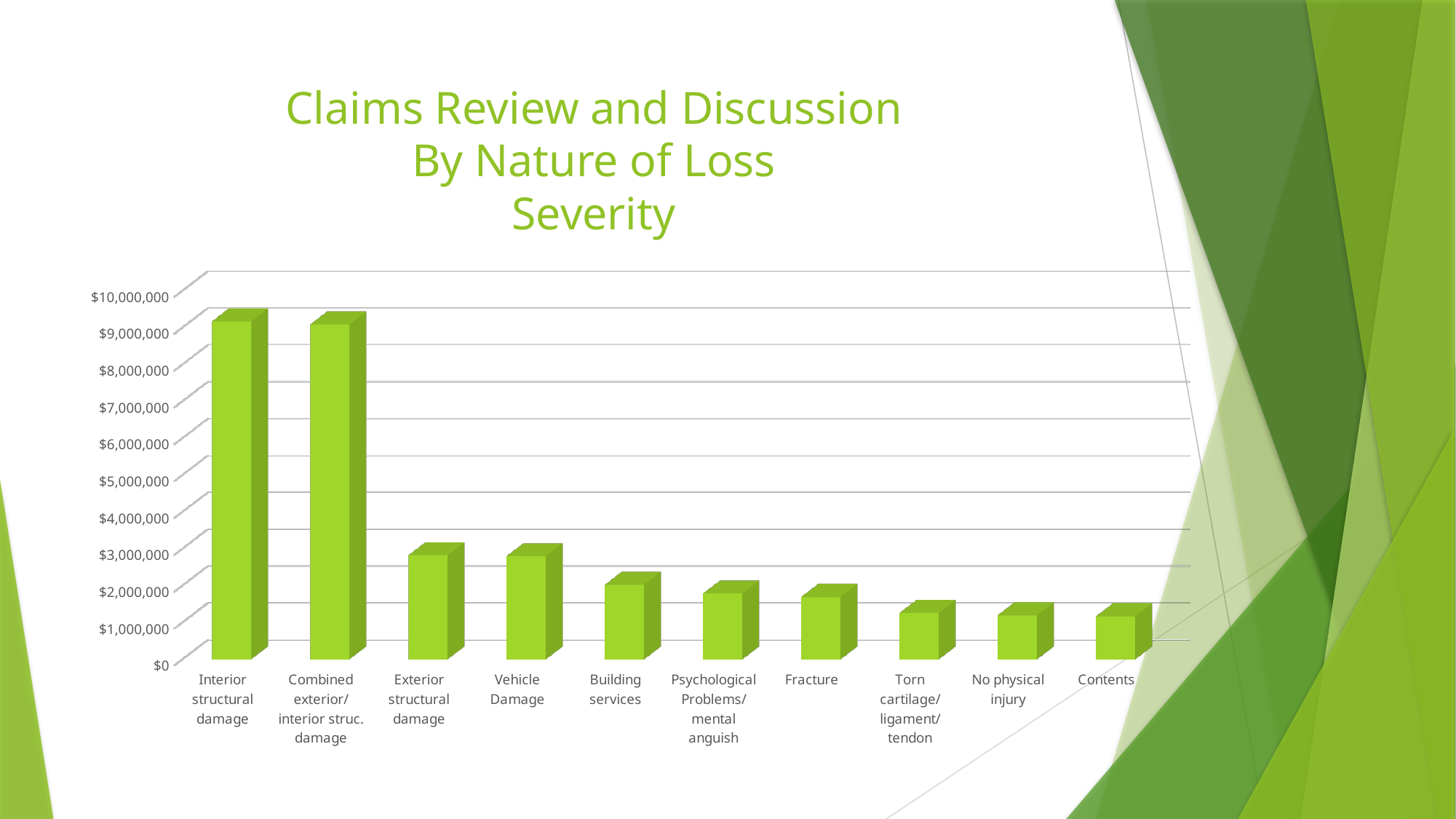
Is the value for Building services greater or less than $1,000,000? greater How many categories are plotted on the x axis of the chart? 10 Do the bar values generally rise or fall from left to right along the x axis? fall Is the value for Fracture greater or less than $3,000,000? less Is the value for Interior structural damage greater or less than $8,000,000? greater Which is larger, the value for Building services or the value for Contents? Building services Which is larger, the value for Interior structural damage or the value for Exterior structural damage? Interior structural damage What kind of chart is shown on the slide? bar chart What is the title of the slide containing the chart? Claims Review and Discussion By Nature of Loss Severity Which is larger, the value for Vehicle Damage or the value for Fracture? Vehicle Damage